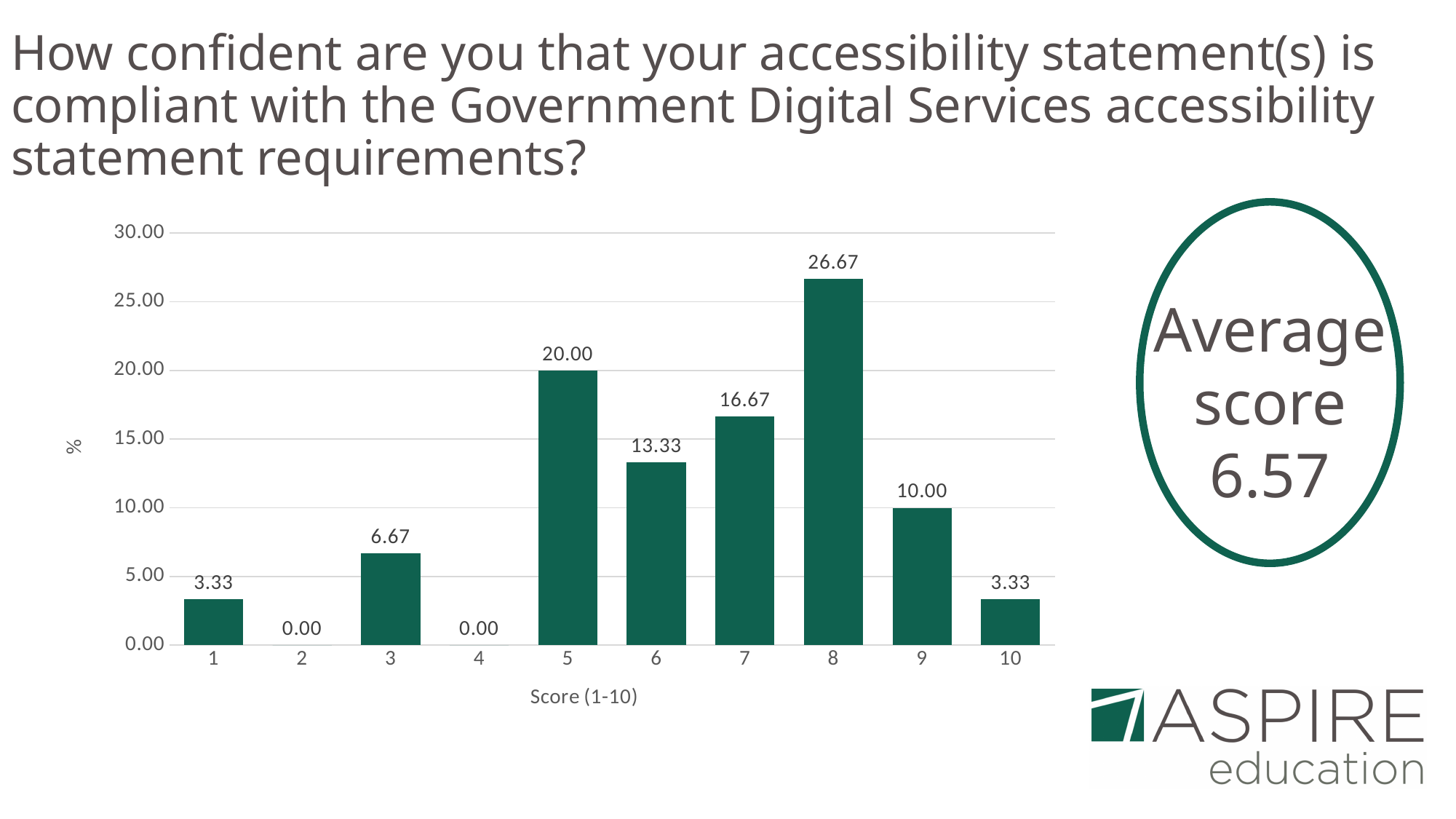
Is the value for score 9 greater or less than 15.00? less What is the value for score 3? 6.67 What percentage of respondents gave a score of 8? 26.67 How many score categories are shown on the x axis? 10 What is the value for score 5? 20.00 Which score has the highest percentage of respondents? 8 What is the label of the x axis? Score (1-10) Which scores have a value of 0.00? 2 and 4 Which has a larger value, score 6 or score 7? Score 7 What is the difference between the values for score 8 and score 5? 6.67 What kind of chart is shown on the slide? Bar chart What average score is shown in the circle on the slide? 6.57